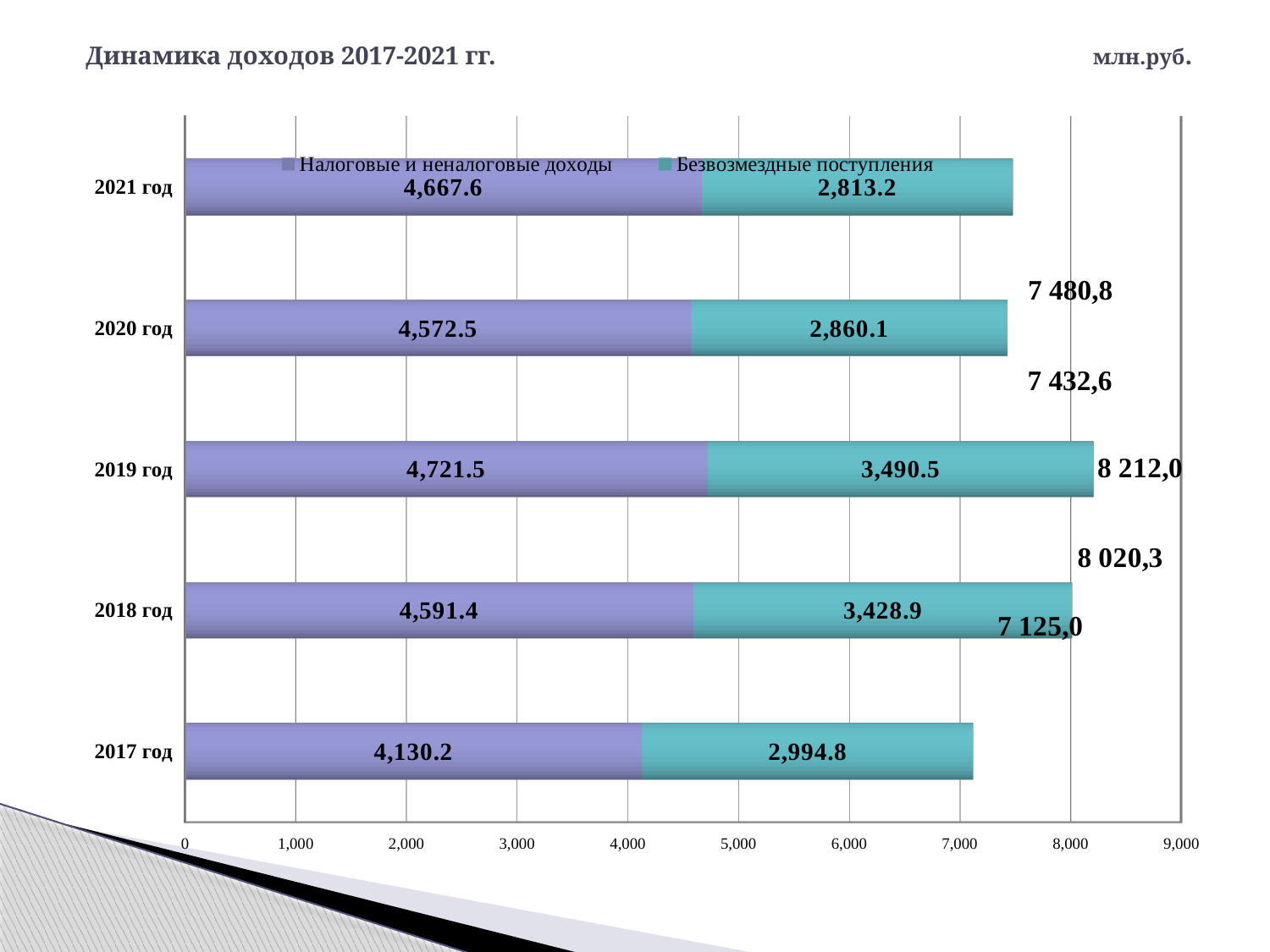
What is the value of Безвозмездные поступления for 2017 год? 2,994.8 What is the difference between Налоговые и неналоговые доходы in 2019 год and 2017 год? 591.3 What is the value of Безвозмездные поступления for 2018 год? 3,428.9 How many years are shown on the chart? 5 What is the total of the stacked bar for 2017 год? 7,125.0 Which is larger: Безвозмездные поступления in 2020 год or in 2021 год? 2020 год What kind of chart is shown on the slide? Stacked bar chart What is the value of Налоговые и неналоговые доходы for 2021 год? 4,667.6 Which year has the highest value for Налоговые и неналоговые доходы? 2019 год What is the total of the stacked bar for 2019 год? 8,212.0 Which year has the lowest value for Безвозмездные поступления? 2021 год How many series does the legend list? 2